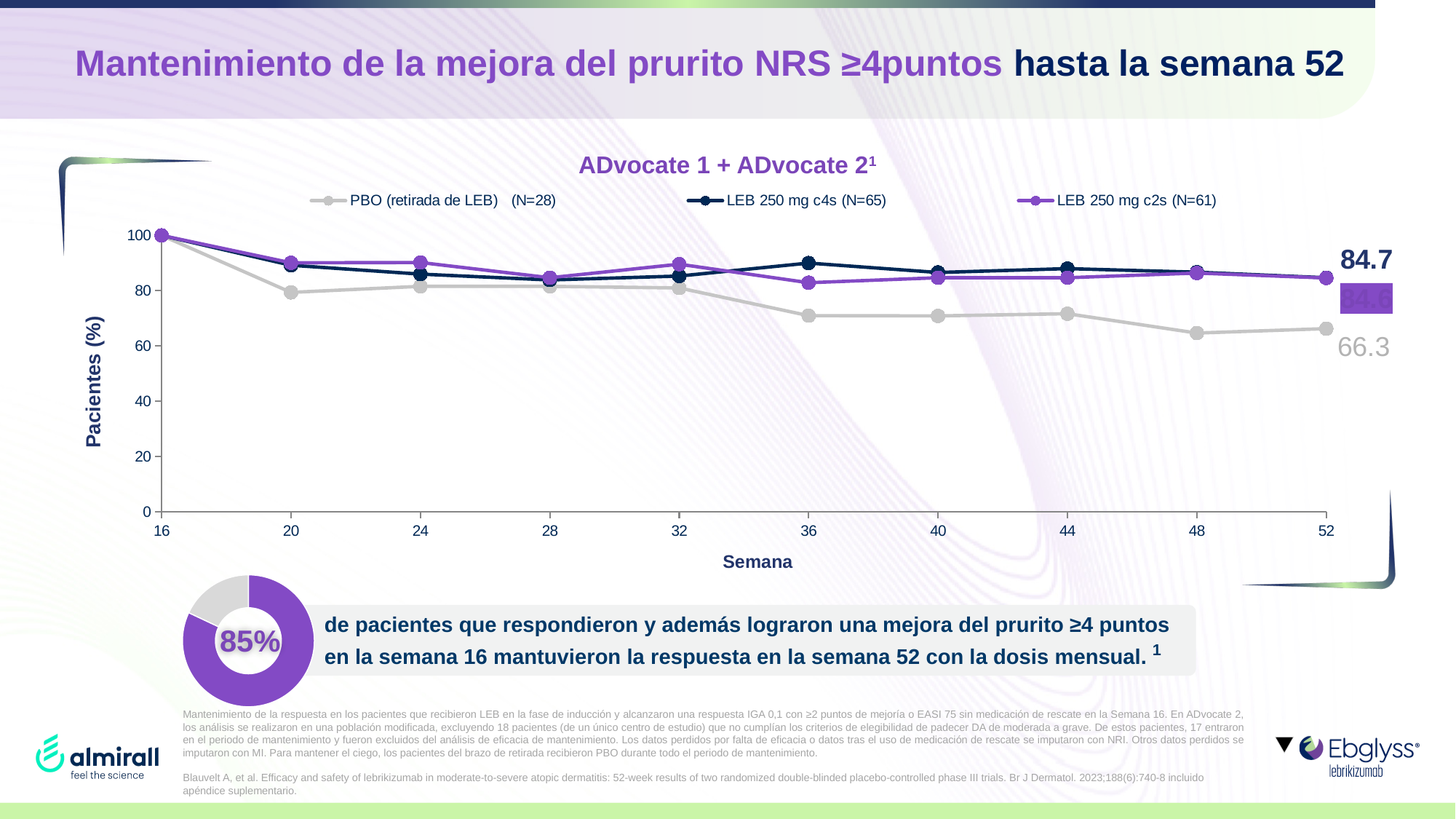
In the line chart, is the value for PBO (retirada de LEB) at week 36 greater or less than 80? less In the line chart, how many series does the legend list? 3 In the line chart, how many week points are shown on the x axis? 10 In the line chart, does the PBO (retirada de LEB) series rise or fall from week 16 to week 52? Fall In the line chart, which series has the lowest value at week 52? PBO (retirada de LEB) (N=28) In the line chart, what is the value for LEB 250 mg c4s (N=65) at week 52? 84.7 In the line chart, what is the difference between the week 52 values of LEB 250 mg c4s (N=65) and PBO (retirada de LEB) (N=28)? 18.4 What kind of chart is the main chart titled 'ADvocate 1 + ADvocate 2'? Line chart In the donut chart at the bottom of the slide, what share is shown by the purple slice? 85% In the line chart, at week 52, which is larger: LEB 250 mg c4s (N=65) or PBO (retirada de LEB) (N=28)? LEB 250 mg c4s (N=65) In the line chart, what is the value for PBO (retirada de LEB) (N=28) at week 52? 66.3 In the line chart, is the value for LEB 250 mg c4s (N=65) at week 36 greater or less than 80? greater